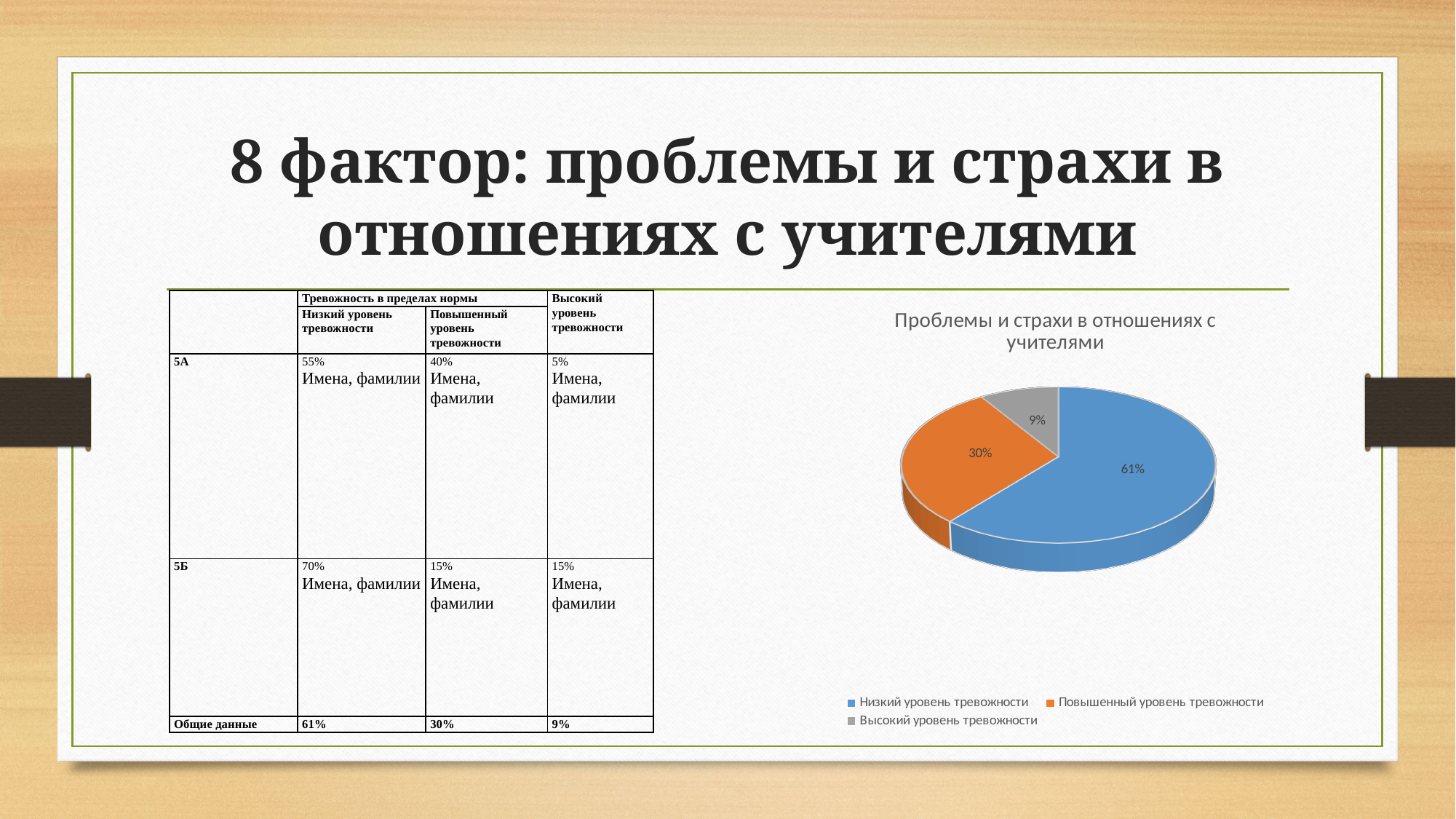
What share of the pie does "Низкий уровень тревожности" have? 61% Which category has the largest slice of the pie? Низкий уровень тревожности How many slices does the pie chart have? 3 What is the difference in percentage points between "Низкий уровень тревожности" and "Повышенный уровень тревожности"? 31 How many entries does the legend list? 3 Which category has the smallest slice of the pie? Высокий уровень тревожности What share of the pie does "Высокий уровень тревожности" have? 9% What colour is the slice for "Высокий уровень тревожности"? Gray What type of chart is shown on the slide? Pie chart What is the title of the chart? Проблемы и страхи в отношениях с учителями Which is larger: the slice for "Повышенный уровень тревожности" or the slice for "Высокий уровень тревожности"? Повышенный уровень тревожности What share of the pie does "Повышенный уровень тревожности" have? 30%